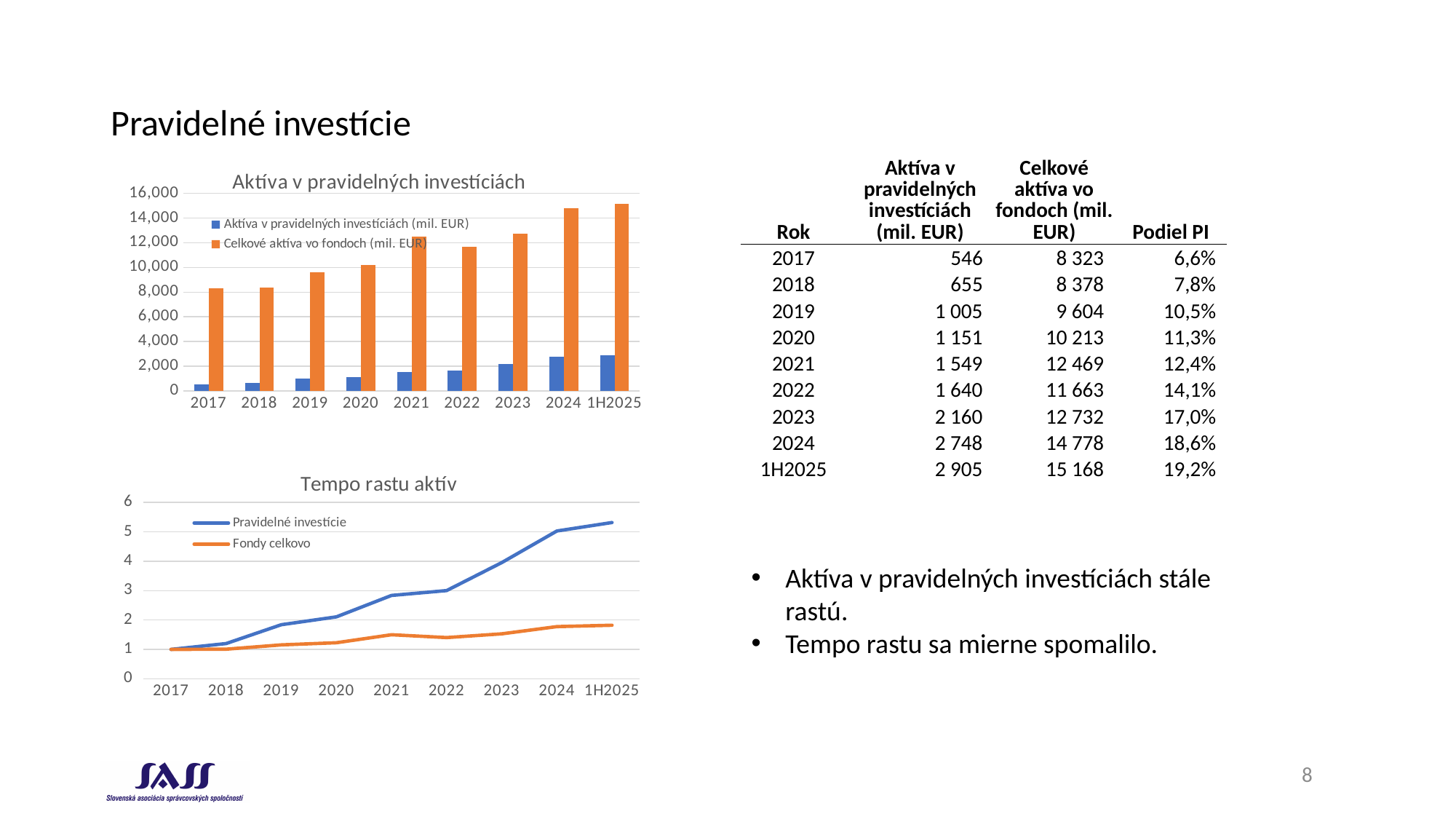
How many series does the legend of the "Tempo rastu aktív" chart list? 2 In the "Aktíva v pravidelných investíciách" chart, which category has the highest value for Celkové aktíva vo fondoch (mil. EUR)? 1H2025 How many categories are shown on the x axis of the "Aktíva v pravidelných investíciách" chart? 9 In the "Aktíva v pravidelných investíciách" chart, which series is shown in orange? Celkové aktíva vo fondoch (mil. EUR) How many series does the legend of the "Aktíva v pravidelných investíciách" chart list? 2 In the "Tempo rastu aktív" chart, is the value for Pravidelné investície in 2024 greater or less than 4? greater In the "Tempo rastu aktív" chart, which series has the higher value in 2023, Pravidelné investície or Fondy celkovo? Pravidelné investície What kind of chart is the "Aktíva v pravidelných investíciách" chart? bar chart What kind of chart is the "Tempo rastu aktív" chart? line chart In the "Aktíva v pravidelných investíciách" chart, which category has the lowest value for Aktíva v pravidelných investíciách (mil. EUR)? 2017 In the "Aktíva v pravidelných investíciách" chart, is the value for Celkové aktíva vo fondoch in 2019 greater or less than 10,000? less In the "Tempo rastu aktív" chart, does the Pravidelné investície line rise or fall from 2017 to 1H2025? rise